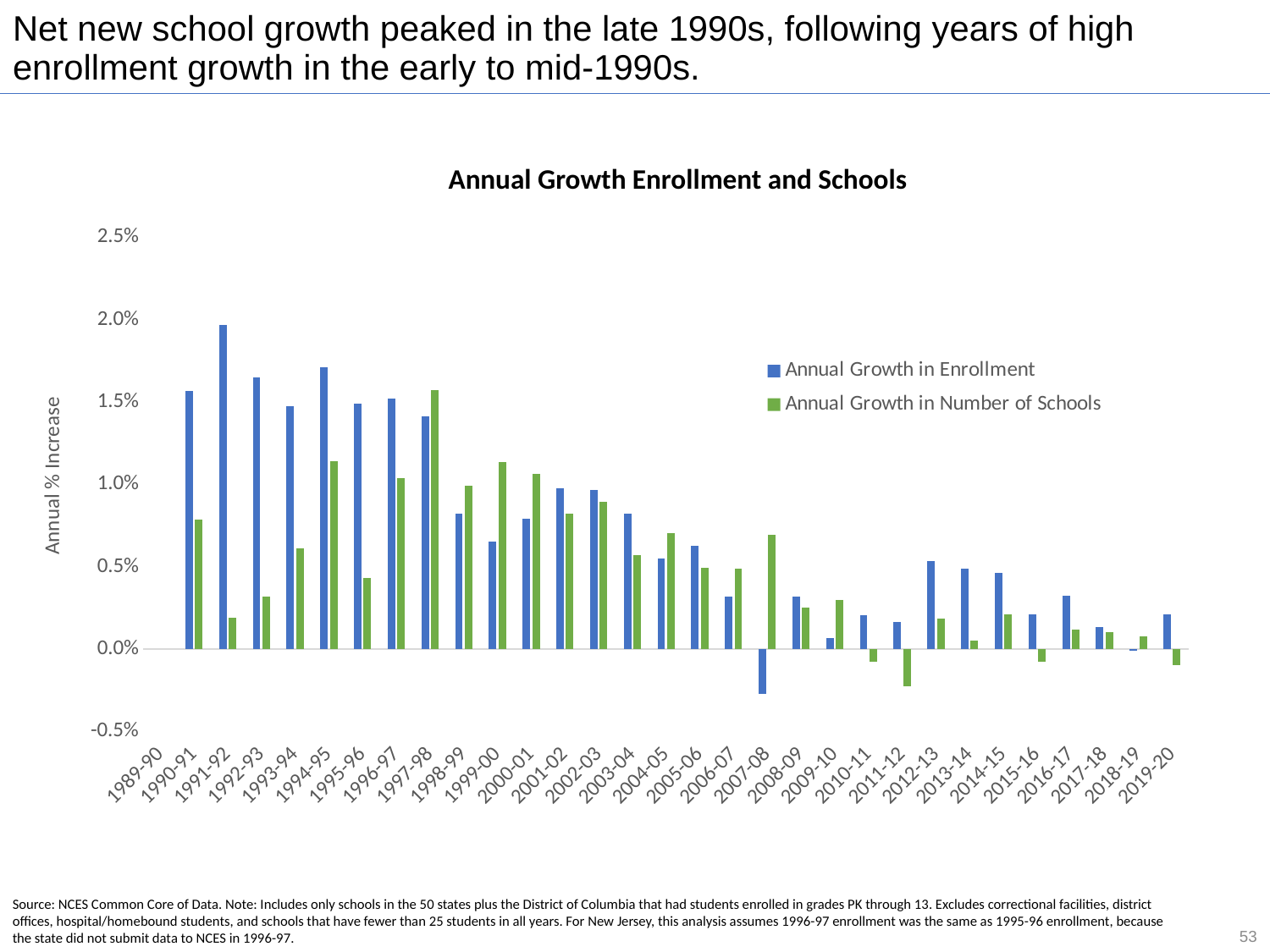
What is the title of the chart? Annual Growth Enrollment and Schools How many series does the legend list? 2 What kind of chart is shown on the slide? Bar chart How many school years are shown on the x axis? 31 In which school year is Annual Growth in Enrollment highest? 1991-92 In which school year is Annual Growth in Number of Schools highest? 1997-98 In which school year is Annual Growth in Number of Schools lowest? 2011-12 Is the Annual Growth in Enrollment for 2007-08 greater or less than 0.0%? less Is the Annual Growth in Number of Schools for 1999-00 greater or less than 1.0%? greater Is the Annual Growth in Enrollment for 1991-92 greater or less than 1.5%? greater In which school year is Annual Growth in Enrollment lowest? 2007-08